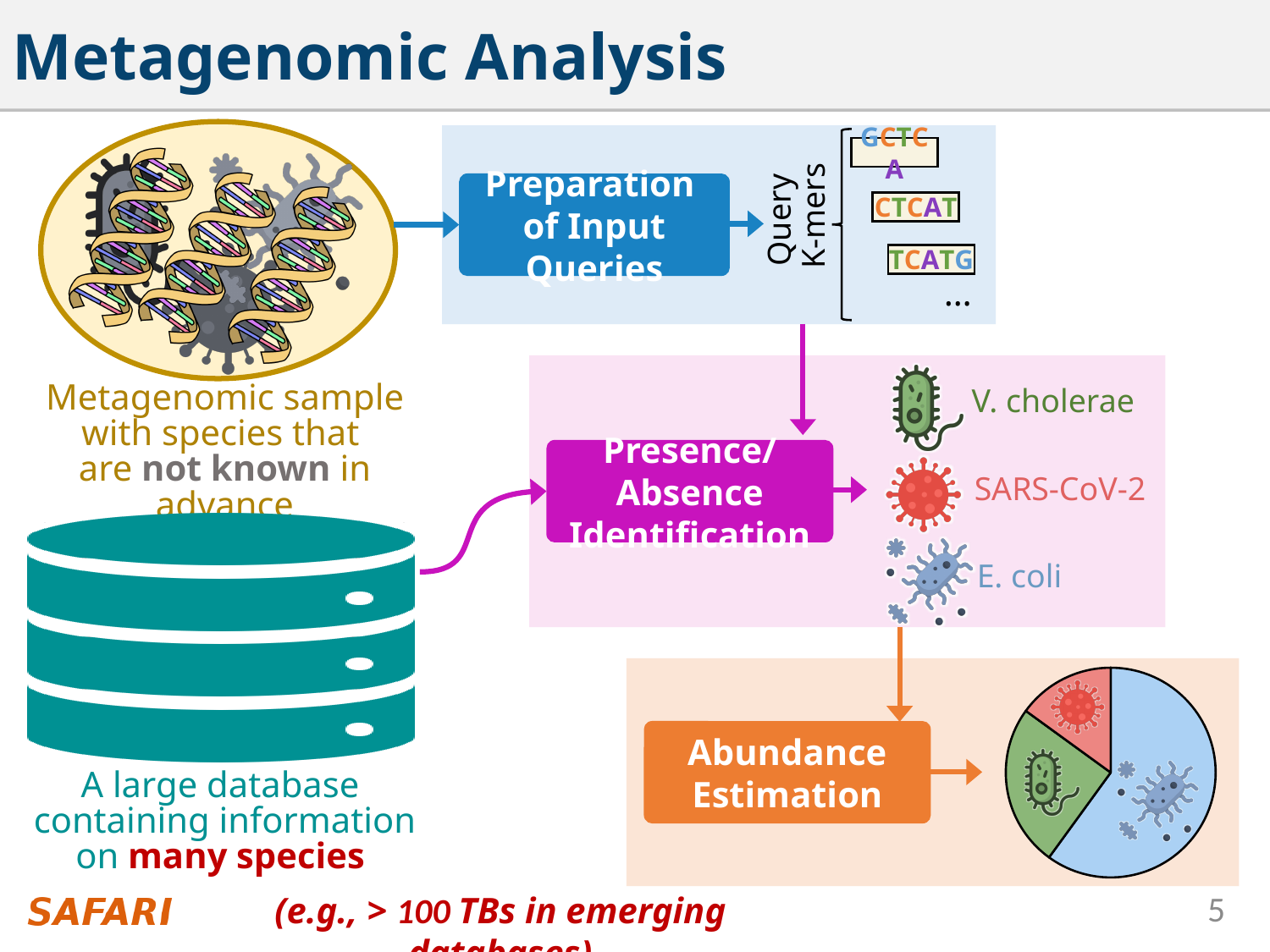
What kind of chart is shown in the Abundance Estimation box? pie chart In the pie chart in the Abundance Estimation box, is the blue slice larger or smaller than the red slice? larger How many slices does the pie chart in the Abundance Estimation box have? 3 Does the pie chart in the Abundance Estimation box show any numeric data labels? No In the pie chart in the Abundance Estimation box, is the blue slice larger or smaller than the green slice? larger Which labelled step of the pipeline produces the pie chart shown on the slide? Abundance Estimation Which colour slice is the largest in the pie chart in the Abundance Estimation box? blue